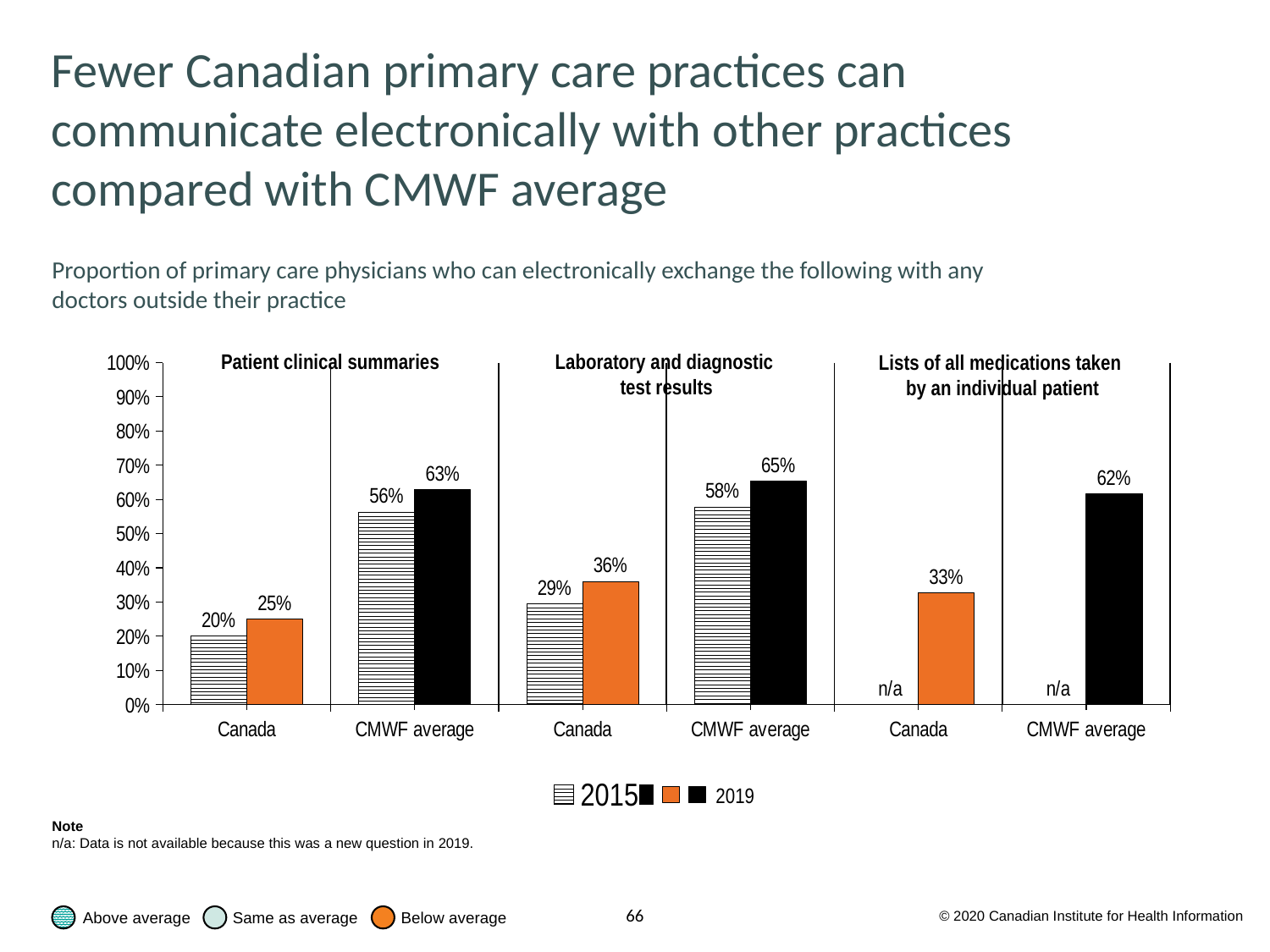
What is the 2015 value for the CMWF average under Laboratory and diagnostic test results? 58% What kind of chart is shown on the slide? Bar chart Which is larger: Canada's 2019 value for Laboratory and diagnostic test results or Canada's 2019 value for Lists of all medications? Canada's 2019 value for Laboratory and diagnostic test results (36%) What is the 2019 value for Canada under Patient clinical summaries? 25% What is the 2015 value for Canada under Laboratory and diagnostic test results? 29% What is shown for the 2015 value for Canada under Lists of all medications taken by an individual patient? n/a What is the difference between the CMWF average and Canada 2019 values for Patient clinical summaries? 38 percentage points By how much did Canada's value for Laboratory and diagnostic test results change from 2015 to 2019? 7 percentage points How many series does the legend list? 2 What is the 2019 value for the CMWF average under Lists of all medications taken by an individual patient? 62% Which bar has the lowest value on the chart? Canada 2015, Patient clinical summaries (20%) Which bar has the highest value on the chart? CMWF average 2019, Laboratory and diagnostic test results (65%)